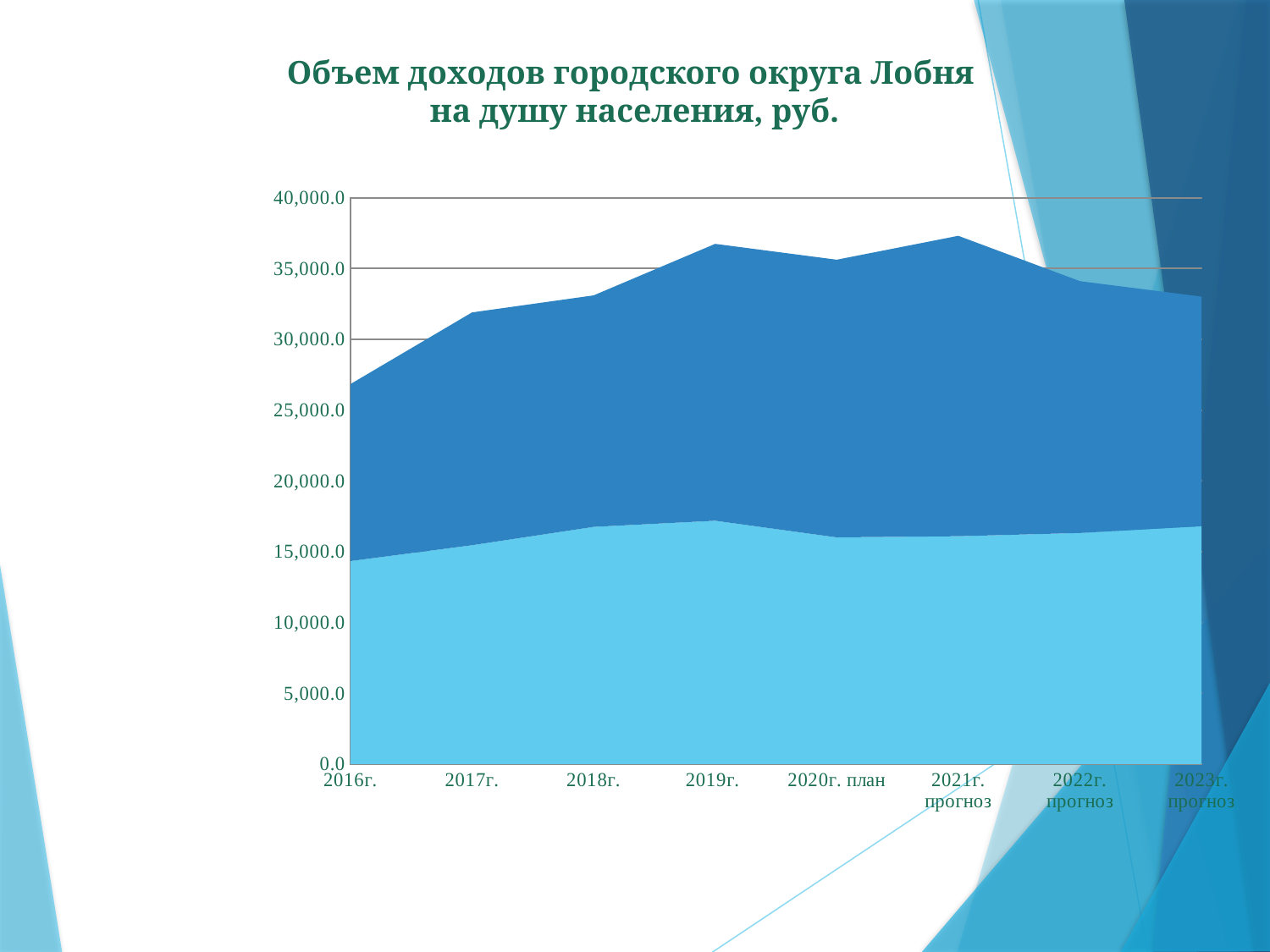
Which category has the lowest total (top of the stacked area)? 2016г. Does the total (top of the stacked area) rise or fall from 2016г. to 2019г.? rise Is the total value (top of the stacked area) for 2016г. greater or less than 30,000.0? less What is the title of the chart? Объем доходов городского округа Лобня на душу населения, руб. What kind of chart is shown on the slide? area chart How many categories are shown along the x axis? 8 Is the value of the lower (light blue) series for 2019г. greater or less than 20,000.0? less Is the value of the lower (light blue) series for 2016г. greater or less than 15,000.0? less Which has the larger total (top of the stacked area): 2016г. or 2017г.? 2017г.